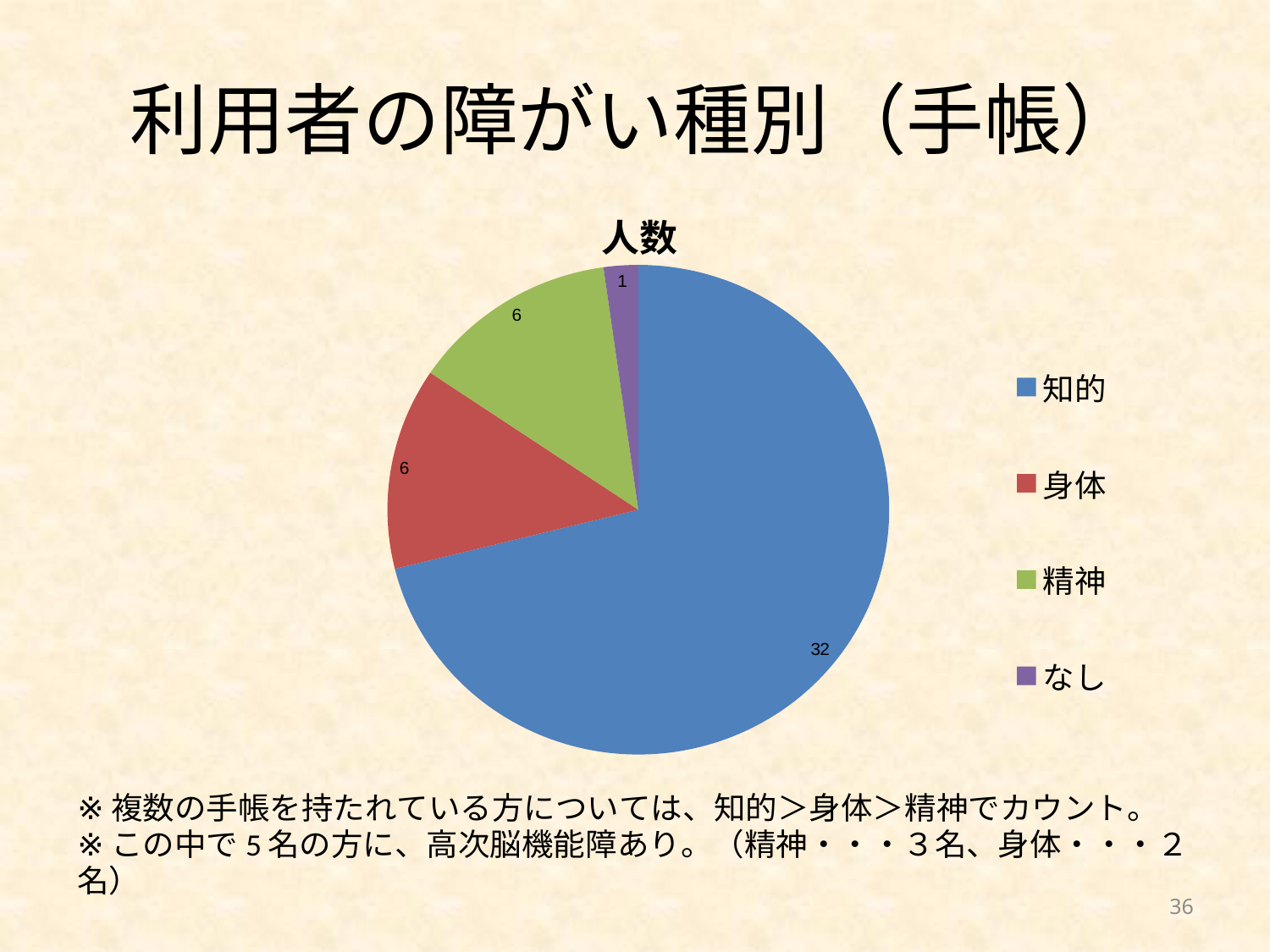
What is the value for 精神? 6 What is the value for 知的? 32 What is the value for 身体? 6 Which is larger, the value for 知的 or the value for 精神? 知的 What is the title of the chart? 人数 How many categories does the pie chart have? 4 What type of chart is shown on the slide? pie chart What is the value for なし? 1 Which category has the largest slice? 知的 Which category has the smallest slice? なし What is the total of all slices in the pie chart? 45 What is the difference between the values for 知的 and 身体? 26